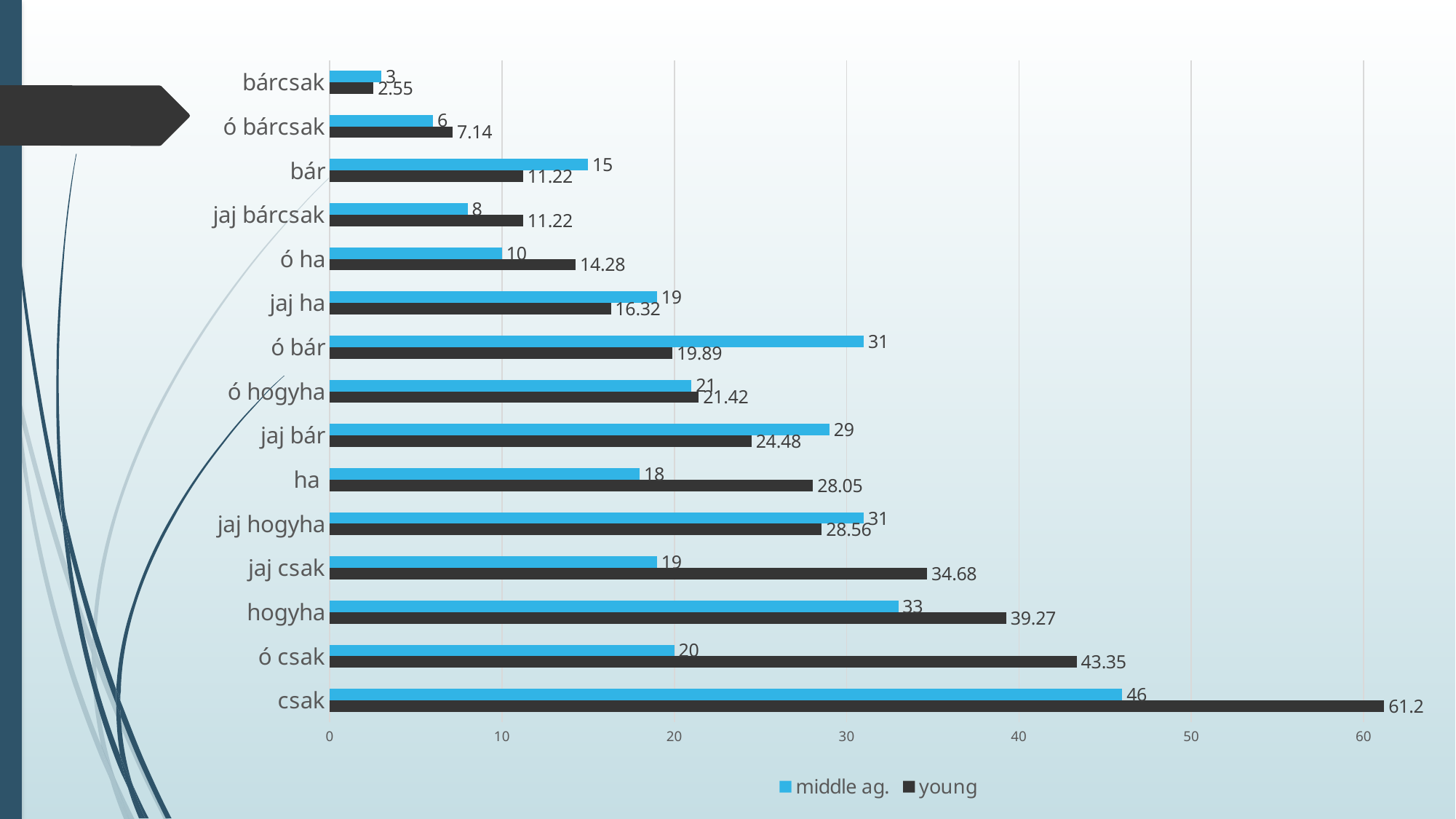
What is the value for "middle ag." for the category "hogyha"? 33 What is the difference between the "young" and "middle ag." values for "ó csak"? 23.35 Which colour represents the "young" series in the legend? dark grey/black How many categories are plotted on the chart? 15 Which category has the lowest value for "middle ag."? bárcsak What is the value for "young" for the category "csak"? 61.2 How many series does the legend list? 2 For the category "ó bár", which series has the larger value, "middle ag." or "young"? middle ag. Which category has the highest value for "young"? csak What kind of chart is shown on the slide? bar chart Is the "young" value for "jaj csak" greater or less than 30? greater What is the value for "young" for the category "ó ha"? 14.28